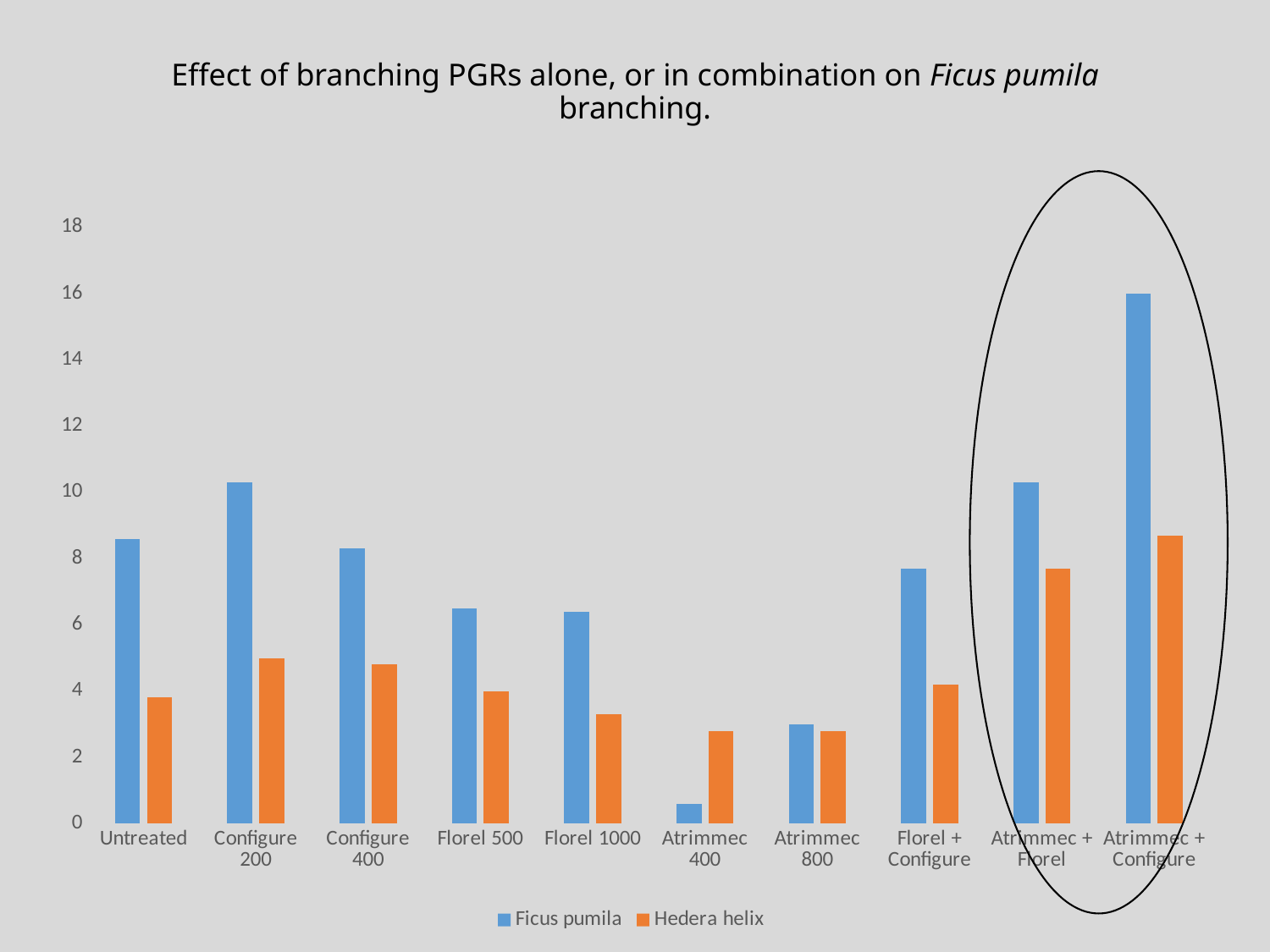
Is the Hedera helix value for Atrimmec + Florel greater or less than 6? greater Which treatment has the highest value for Ficus pumila? Atrimmec + Configure Is the Ficus pumila value for Atrimmec + Configure greater or less than 14? greater How many series does the legend list? 2 How many treatment categories are shown on the x axis? 10 What kind of chart is shown on the slide? bar chart Is the Ficus pumila value for Atrimmec 400 greater or less than 2? less Which treatment has the highest value for Hedera helix? Atrimmec + Configure For the Untreated category, which series has the larger value, Ficus pumila or Hedera helix? Ficus pumila Which treatment has the lowest value for Ficus pumila? Atrimmec 400 For Ficus pumila, which treatment has the larger value, Configure 200 or Florel 500? Configure 200 Which colour represents Hedera helix in the chart? orange